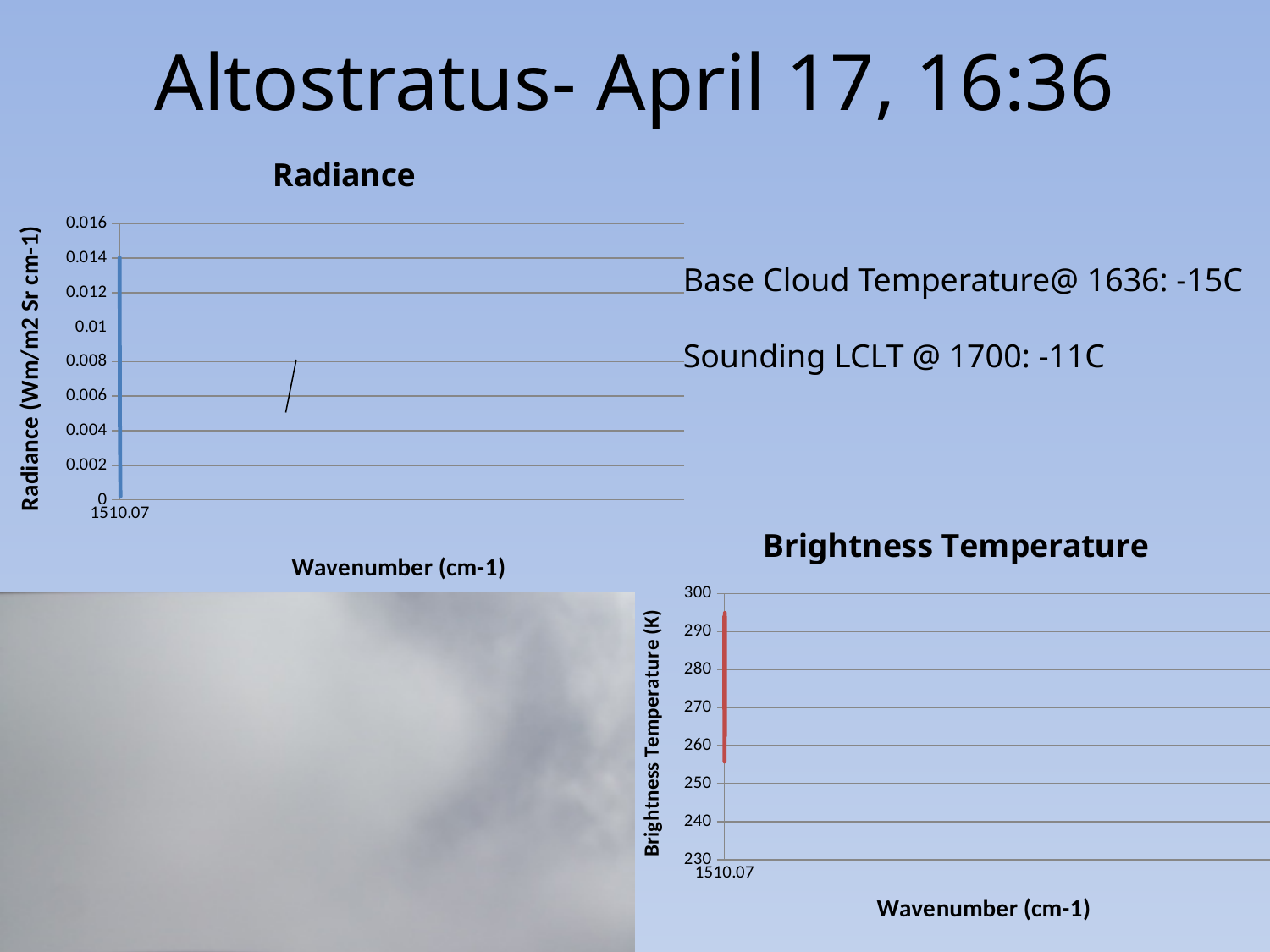
What kind of chart is the Radiance chart? line chart What kind of chart is the Brightness Temperature chart? line chart On the Brightness Temperature chart, is the lowest plotted brightness temperature greater or less than 270? less On the Radiance chart, is the highest plotted radiance value greater or less than 0.012? greater On the Brightness Temperature chart, is the highest plotted brightness temperature greater or less than 280? greater What is the y-axis title of the Radiance chart? Radiance (Wm/m2 Sr cm-1) What is the x-axis title of the Brightness Temperature chart? Wavenumber (cm-1)